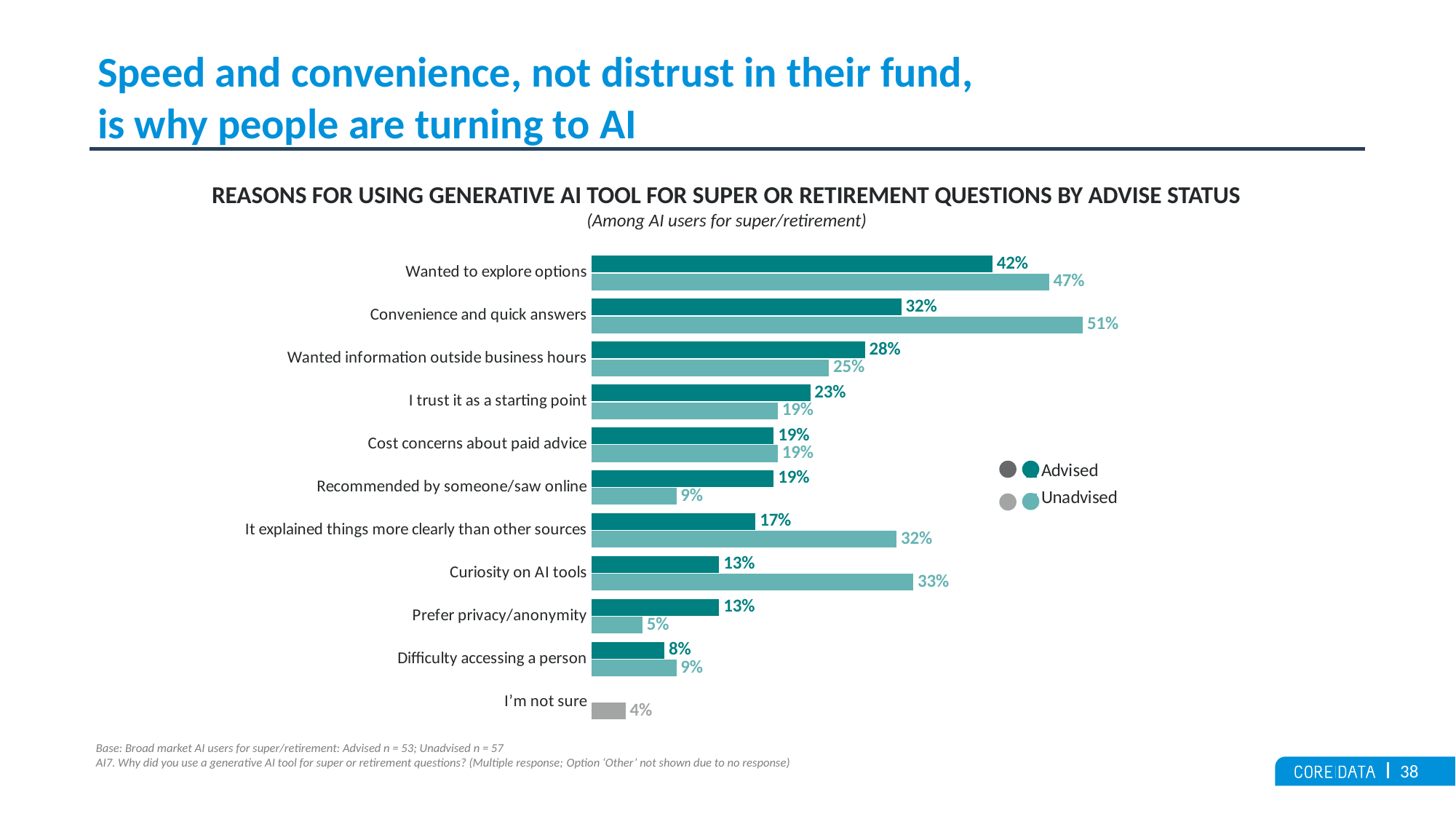
What percentage of Unadvised respondents said 'Curiosity on AI tools'? 33% Which reason has the highest value for the Unadvised series? Convenience and quick answers What is the Unadvised value for 'Prefer privacy/anonymity'? 5% For 'It explained things more clearly than other sources', which group has the larger value, Advised or Unadvised? Unadvised Which reason has the lowest value for the Advised series? Difficulty accessing a person What percentage of Advised respondents said 'Convenience and quick answers'? 32% How many series does the legend list? 2 What is the difference between the Unadvised and Advised values for 'Convenience and quick answers'? 19 percentage points What type of chart is shown on the slide? Bar chart How many reasons (categories) are listed on the chart? 11 For 'Wanted information outside business hours', which group has the larger value, Advised or Unadvised? Advised Which reason has the highest value for the Advised series? Wanted to explore options